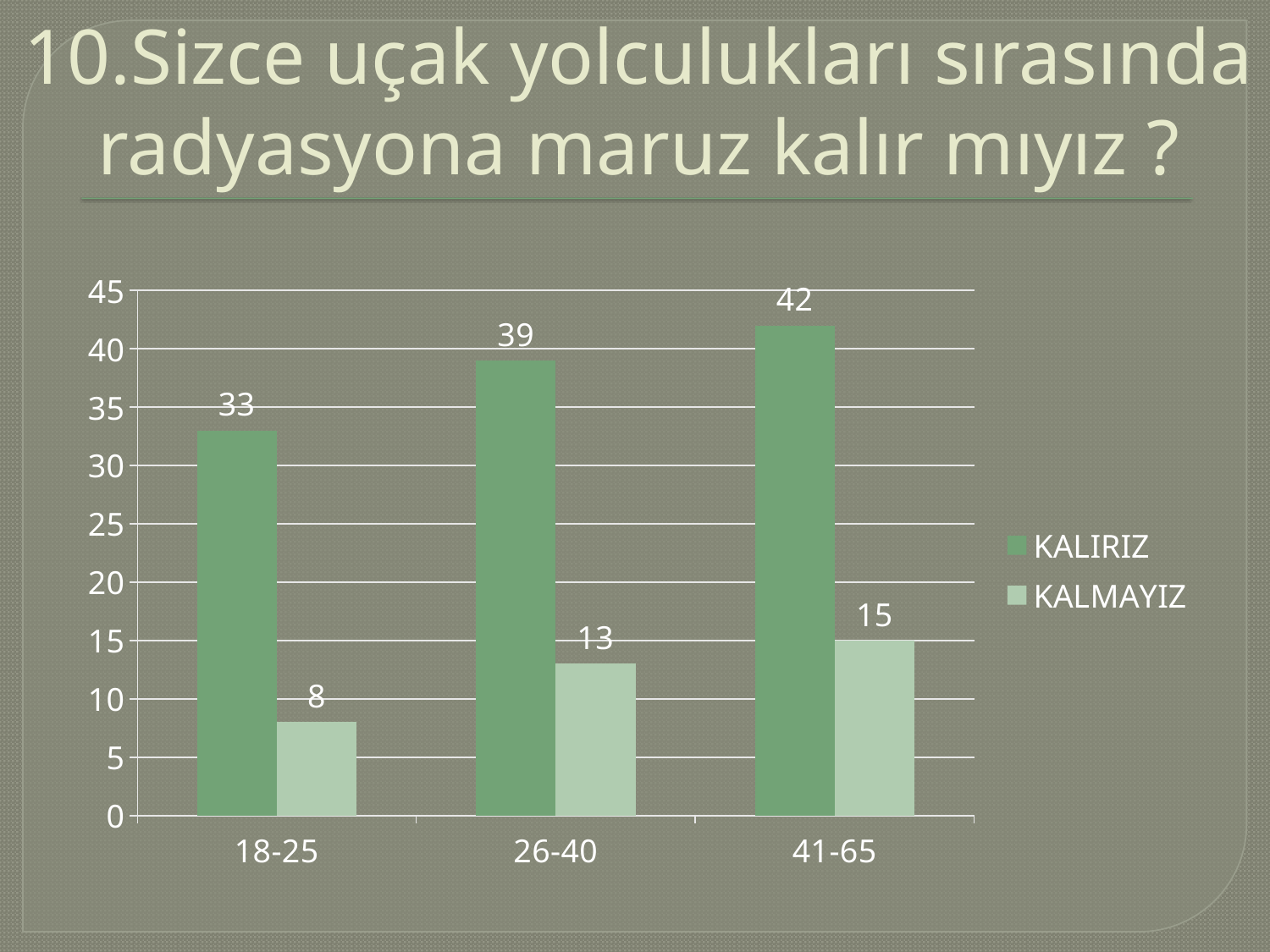
Which age group has the lowest KALMAYIZ value? 18-25 Do the KALMAYIZ values rise or fall from the 18-25 group to the 41-65 group? rise What is the difference between the KALIRIZ and KALMAYIZ values for the 41-65 age group? 27 What is the KALMAYIZ value for the 26-40 age group? 13 What is the KALIRIZ value for the 18-25 age group? 33 What is the KALIRIZ value for the 41-65 age group? 42 How many series does the legend list? 2 Which age group has the highest KALIRIZ value? 41-65 What are the two series names listed in the legend? KALIRIZ and KALMAYIZ How many age groups are shown on the x axis? 3 Which is larger for the 26-40 age group, KALIRIZ or KALMAYIZ? KALIRIZ What kind of chart is shown on the slide? bar chart